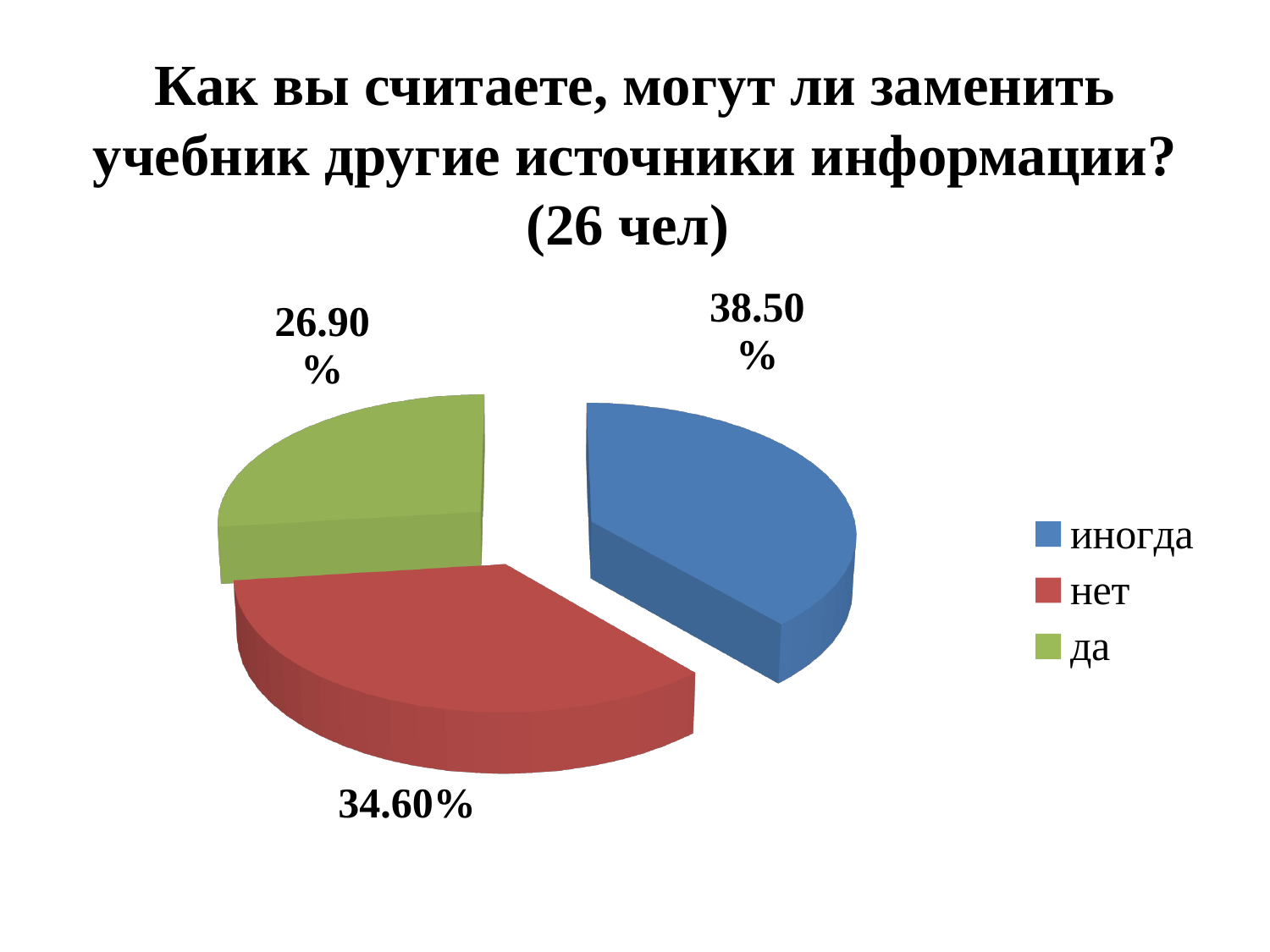
What percentage of respondents answered "иногда"? 38.50% What percentage of respondents answered "да"? 26.90% What kind of chart is shown on the slide? pie chart Which is larger, the share for "нет" or the share for "да"? нет What percentage of respondents answered "нет"? 34.60% What is the difference in percentage points between the "иногда" share and the "да" share? 11.60 Which colour represents "нет" in the pie chart? red Which answer has the largest share of the pie? иногда How many entries does the legend list? 3 How many people were surveyed according to the chart title? 26 Which answer has the smallest share of the pie? да How many slices does the pie chart have? 3